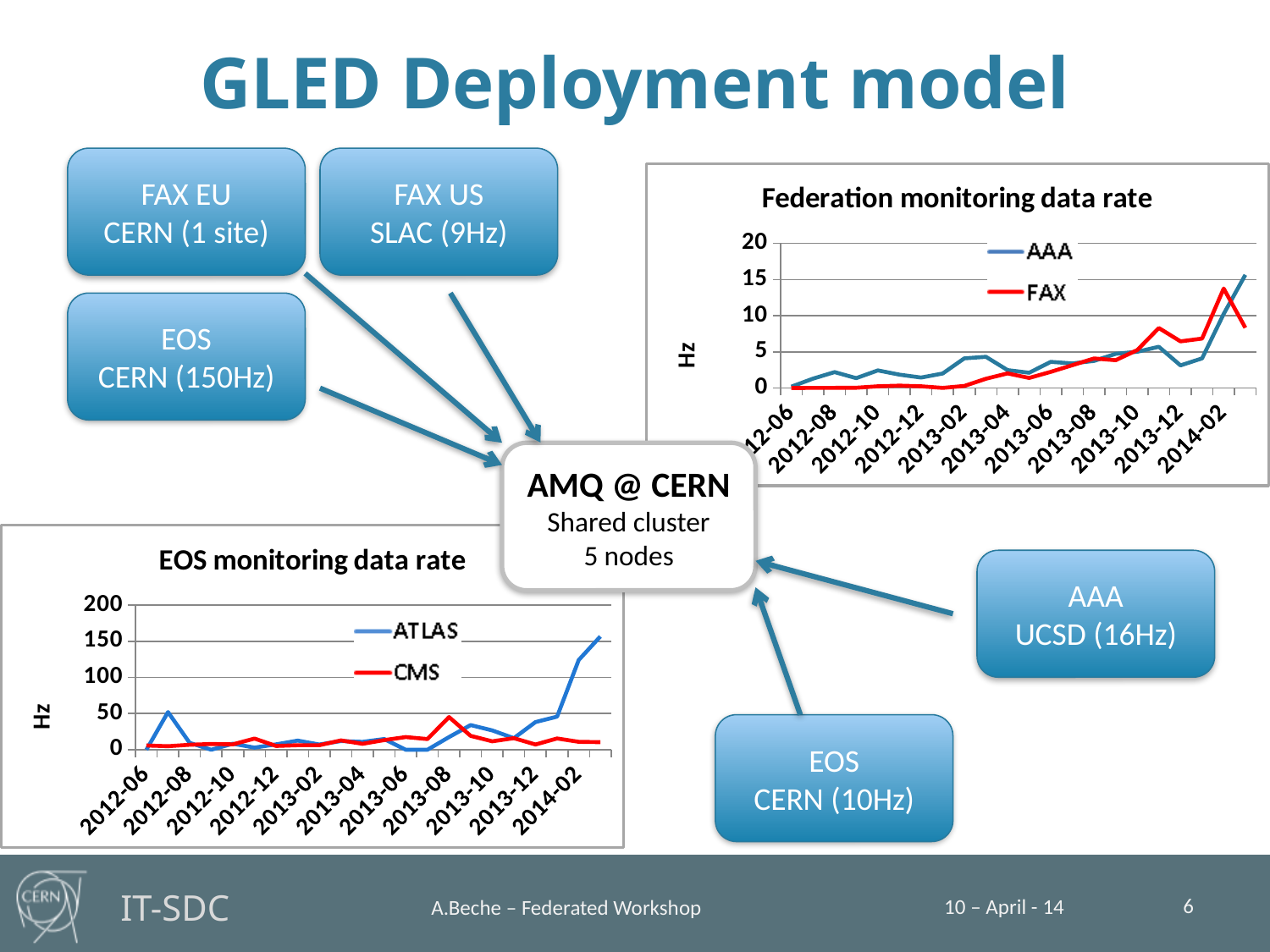
In the 'EOS monitoring data rate' chart, is the CMS value at 2014-02 greater or less than 50? less How many series does the legend of the 'Federation monitoring data rate' chart list? 2 What kind of chart is the 'Federation monitoring data rate' chart? line chart In the 'EOS monitoring data rate' chart, is the ATLAS value at 2014-02 greater or less than 100? greater In the 'Federation monitoring data rate' chart, which series has the higher value at 2014-02, AAA or FAX? FAX What kind of chart is the 'EOS monitoring data rate' chart? line chart What is the y-axis label on the 'Federation monitoring data rate' chart? Hz In the 'EOS monitoring data rate' chart, which series has the higher value at 2014-02, ATLAS or CMS? ATLAS Which two series are shown in the legend of the 'EOS monitoring data rate' chart? ATLAS and CMS In the 'Federation monitoring data rate' chart, does the AAA series overall rise or fall from 2012-06 to 2014-02? rise In the 'Federation monitoring data rate' chart, is the FAX value at 2012-06 greater or less than 5? less